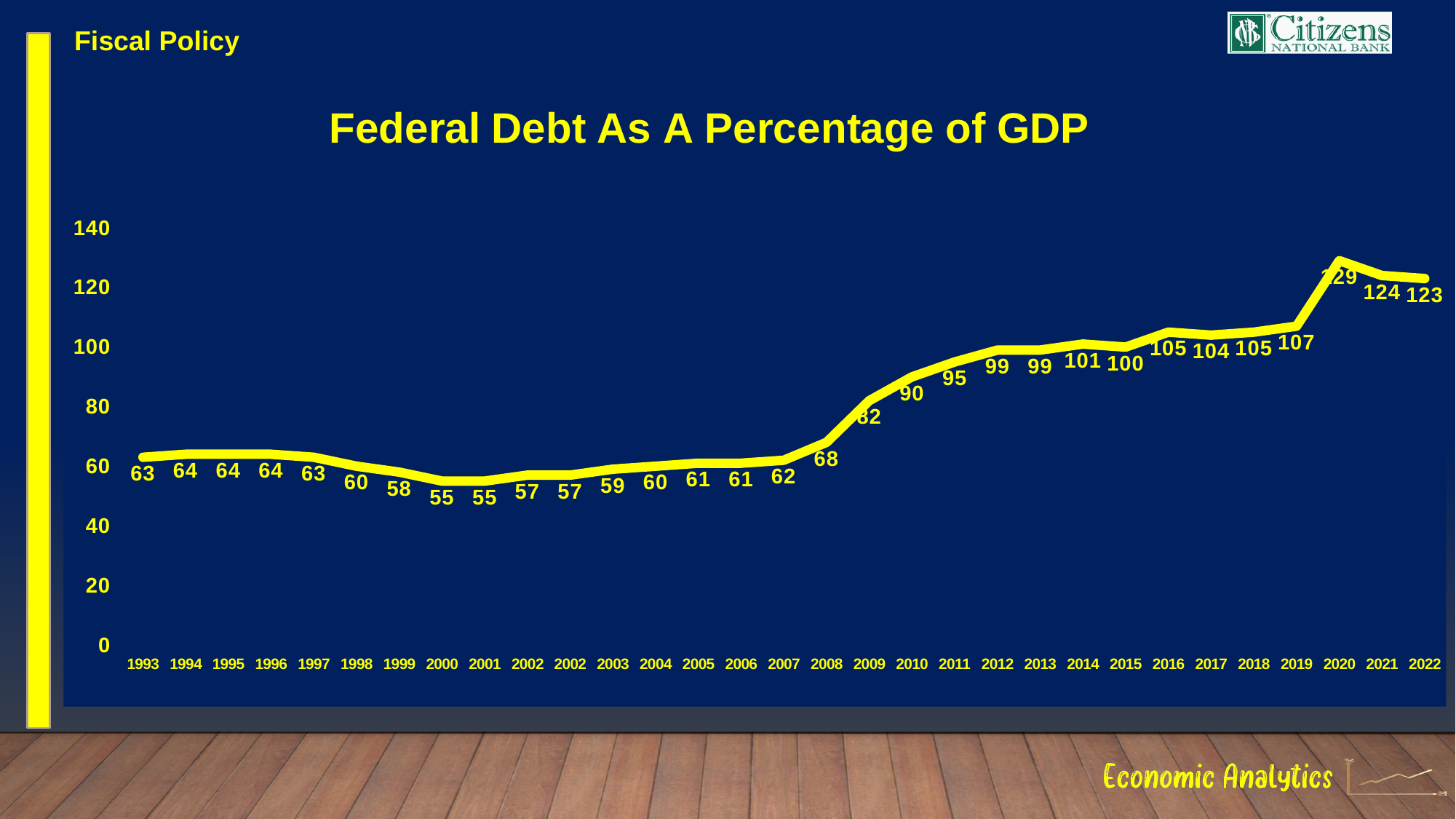
What is the value for 2016? 105 Which year has the larger value, 2009 or 2019? 2019 By how much does the value for 2022 exceed the value for 1993? 60 What is the lowest value plotted on the chart? 55 What is the value for 2022? 123 Which year has the highest federal debt as a percentage of GDP? 2020 What is the federal debt as a percentage of GDP in 2020? 129 Is the value for 2012 greater or less than 80? greater How many data points are plotted on the chart? 31 What value is shown for 2008? 68 Do the values rise or fall from 2008 to 2012? rise What kind of chart is shown on the slide? line chart